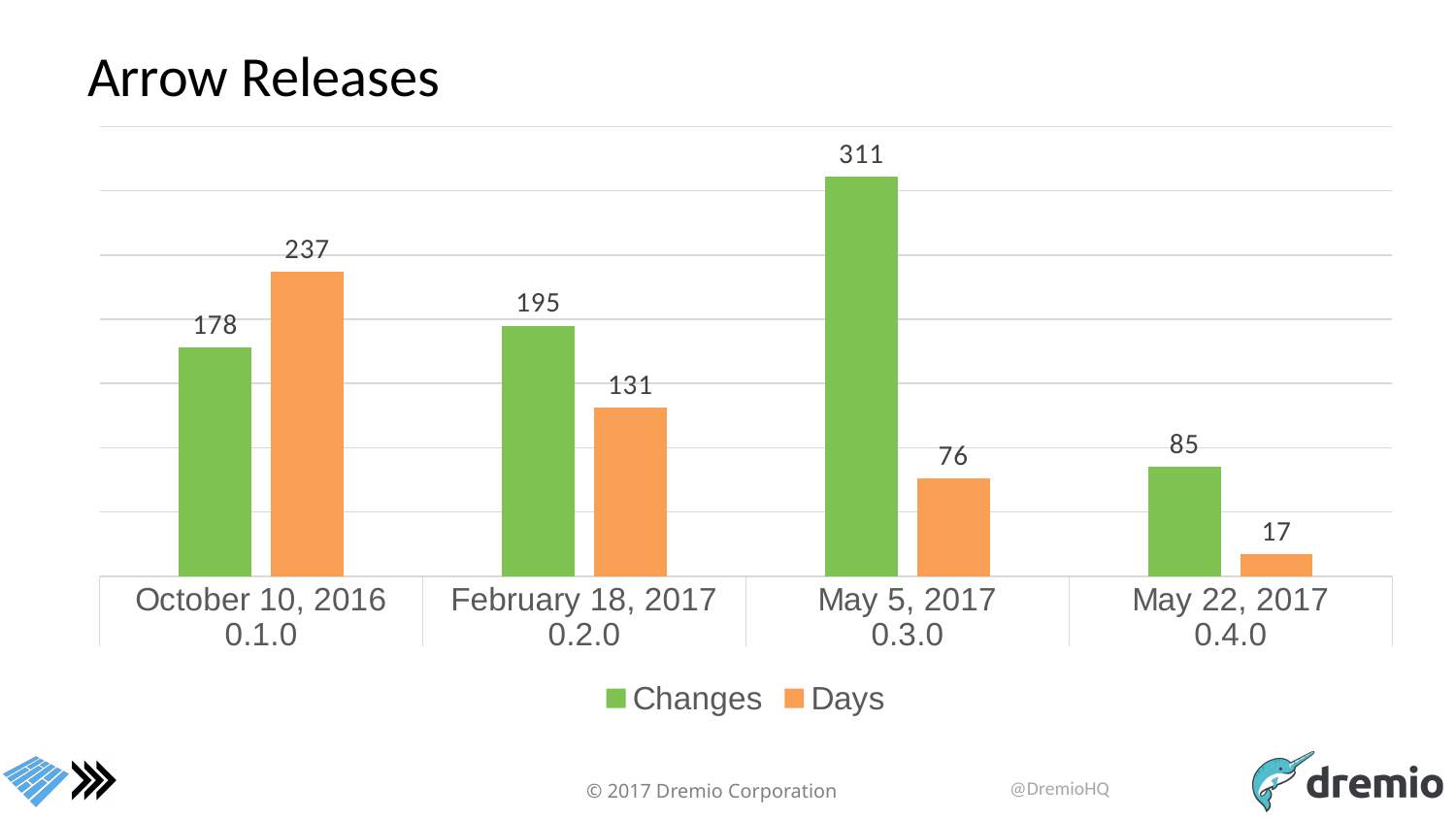
What is the value of Days for the 0.1.0 release (October 10, 2016)? 237 What kind of chart is shown on the slide? Bar chart Do the Days values rise or fall from the first release to the last? Fall How many releases are shown on the x axis? 4 For the 0.1.0 release (October 10, 2016), which is larger: Changes or Days? Days What is the difference between Changes and Days for the 0.2.0 release (February 18, 2017)? 64 What is the title of the chart? Arrow Releases What is the value of Changes for the 0.3.0 release (May 5, 2017)? 311 Which release has the lowest number of Days? May 22, 2017 (0.4.0) What is the value of Days for the 0.4.0 release (May 22, 2017)? 17 How many series does the legend list? 2 Which release has the highest number of Changes? May 5, 2017 (0.3.0)